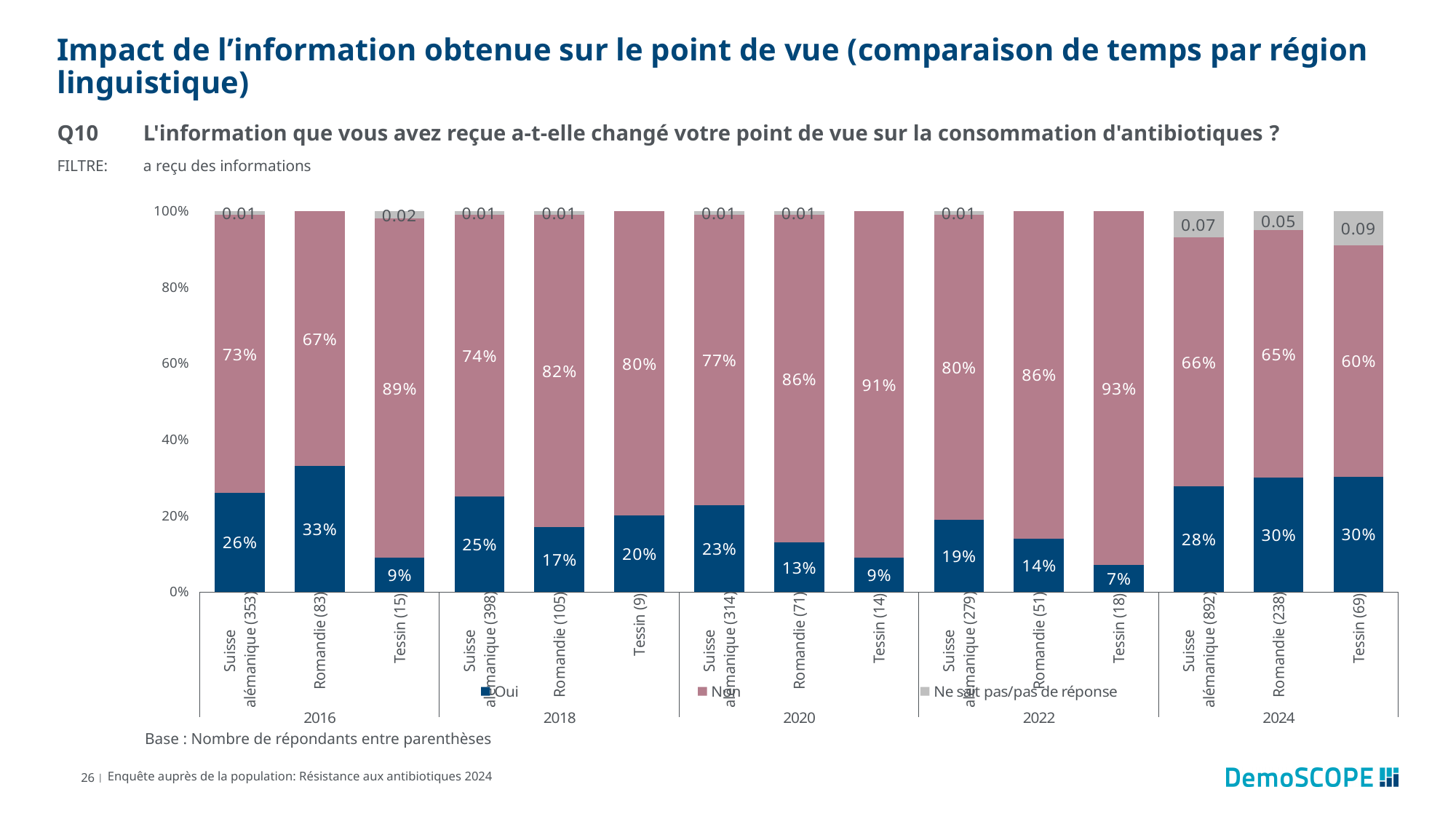
What percentage of Tessin (15) respondents in 2016 answered "Oui"? 9% In 2018, which region has the larger "Oui" value: Suisse alémanique (398) or Romandie (105)? Suisse alémanique (398) Which bar has the highest "Oui" value across all years and regions? Romandie (83) in 2016 Which bar has the lowest "Oui" value across all years and regions? Tessin (18) in 2022 How many bars are plotted in the chart? 15 In 2020, what is the difference between the "Non" values for Tessin (14) and Suisse alémanique (314)? 14 percentage points What is the "Non" value for Romandie (51) in 2022? 86% What is the "Oui" value for Suisse alémanique (892) in 2024? 28% How many series does the legend list? 3 In 2016, how many percentage points higher is the "Oui" value for Romandie (83) than for Tessin (15)? 24 percentage points What is the "Non" value for Tessin (18) in 2022? 93% What kind of chart is shown on the slide? Stacked bar chart